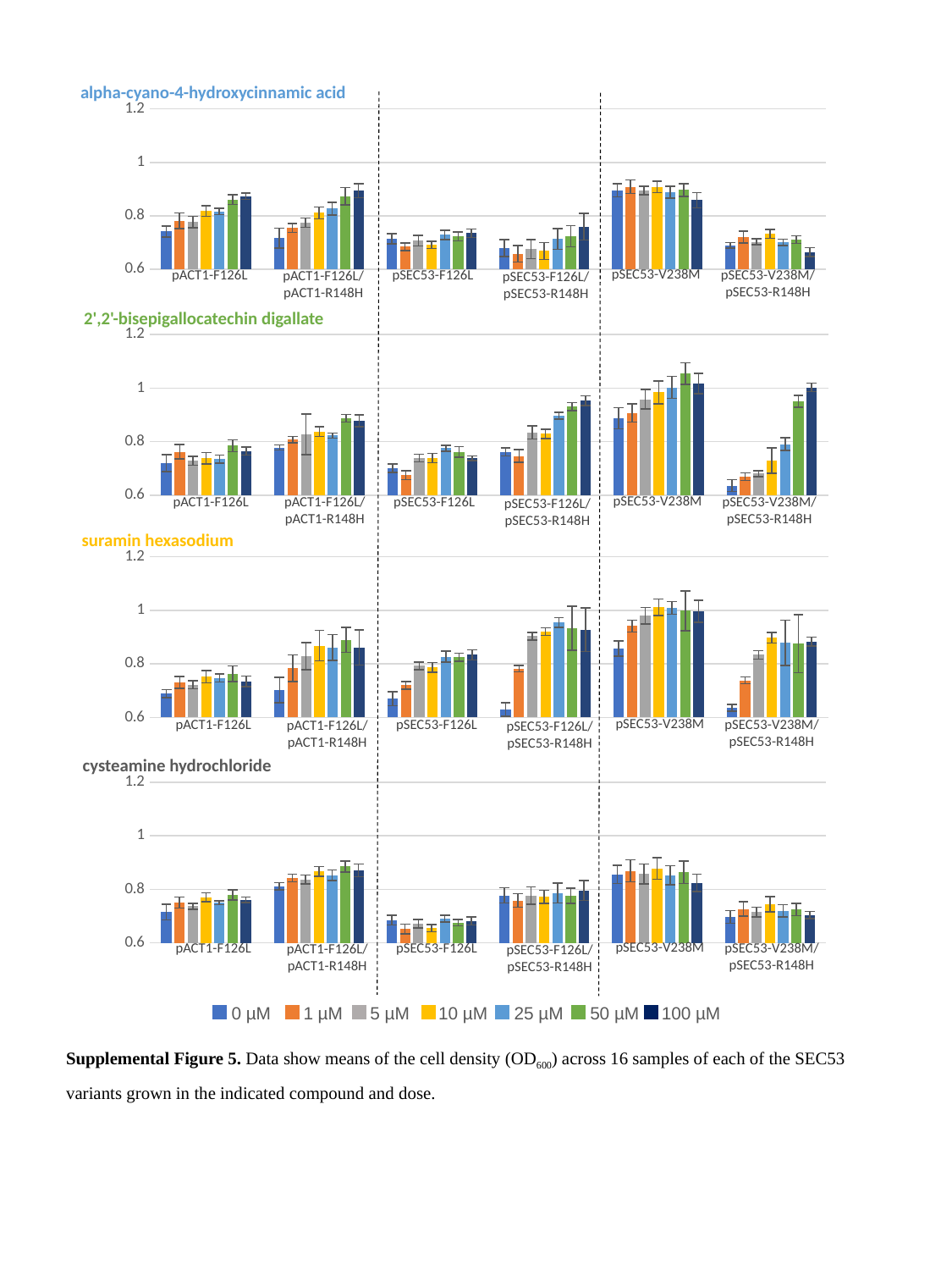
In the suramin hexasodium chart, is the 0 µM value for pSEC53-F126L/pSEC53-R148H greater or less than 0.8? less In the 2',2'-bisepigallocatechin digallate chart, is the 50 µM value for pSEC53-V238M greater or less than 1? greater In the alpha-cyano-4-hydroxycinnamic acid chart, which category has the highest 0 µM value? pSEC53-V238M In the alpha-cyano-4-hydroxycinnamic acid chart, is the 100 µM value for pSEC53-V238M/pSEC53-R148H greater or less than 0.8? less In the cysteamine hydrochloride chart, which is larger, the 0 µM value for pACT1-F126L or the 0 µM value for pACT1-F126L/pACT1-R148H? pACT1-F126L/pACT1-R148H What is the title of the third chart from the top? suramin hexasodium In the suramin hexasodium chart, how many categories are shown on the x axis? 6 In the cysteamine hydrochloride chart, which category has the lowest 10 µM value? pSEC53-F126L What is the maximum value shown on the y axis of each chart? 1.2 How many series does the legend at the bottom of the slide list? 7 In the 2',2'-bisepigallocatechin digallate chart, for pSEC53-V238M/pSEC53-R148H, do the values rise or fall as the dose increases from 0 µM to 100 µM? rise In the alpha-cyano-4-hydroxycinnamic acid chart, what kind of chart is shown? Bar chart